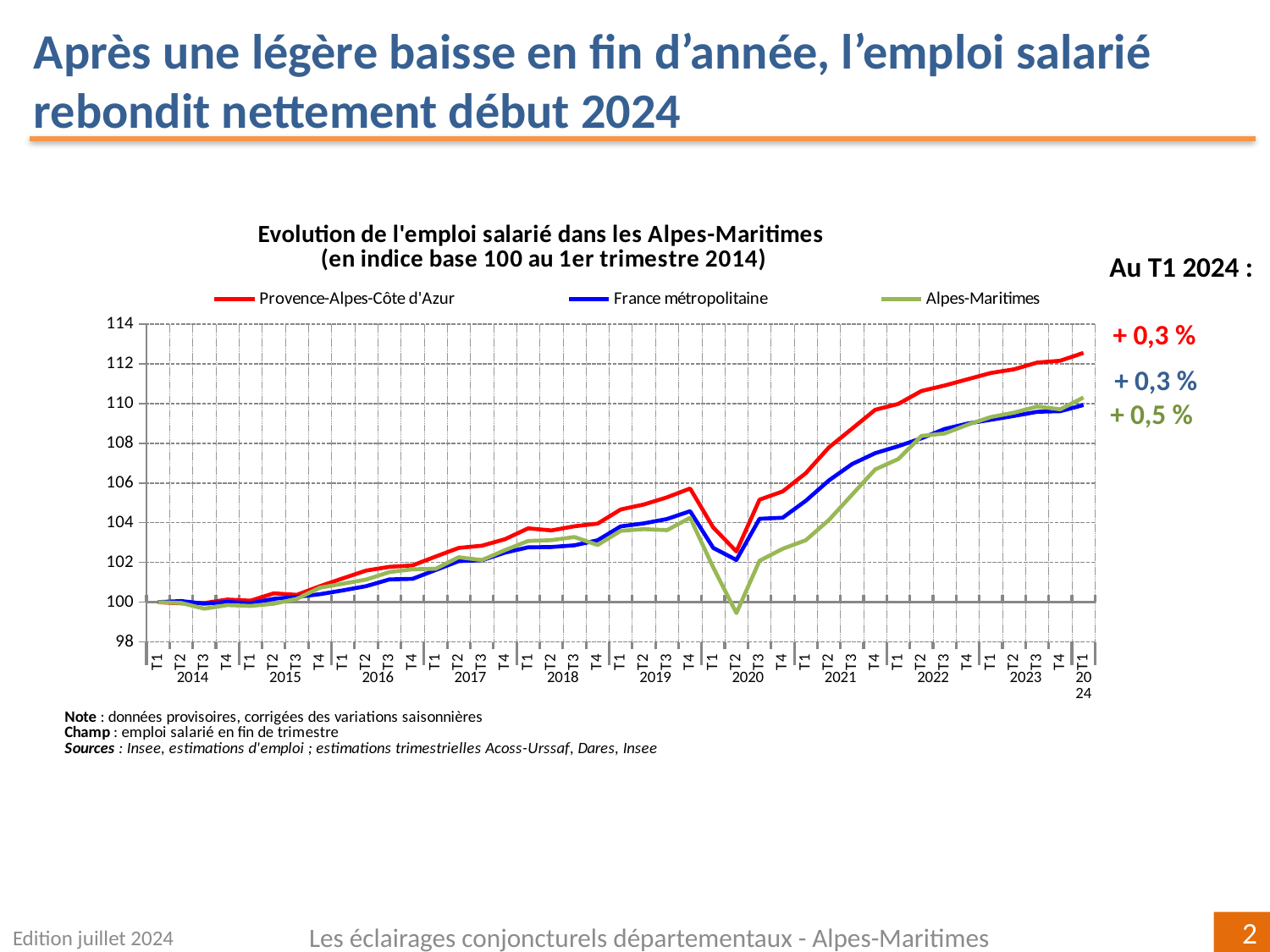
Is the value for Alpes-Maritimes at T4 2021 greater or less than 104? greater How many series does the legend list? 3 Which series has the lowest value at T2 2020? Alpes-Maritimes According to the annotation on the right, what is the change for Alpes-Maritimes at T1 2024? + 0,5 % Is the value for Alpes-Maritimes at T2 2020 greater or less than 102? less At T1 2024, which is higher: Provence-Alpes-Côte d'Azur or France métropolitaine? Provence-Alpes-Côte d'Azur What kind of chart is shown on the slide? line chart Is the value for Provence-Alpes-Côte d'Azur at T1 2024 greater or less than 110? greater What is the title of the chart? Evolution de l'emploi salarié dans les Alpes-Maritimes (en indice base 100 au 1er trimestre 2014) Which series are listed in the legend? Provence-Alpes-Côte d'Azur, France métropolitaine, Alpes-Maritimes Which series has the highest value at T1 2024? Provence-Alpes-Côte d'Azur